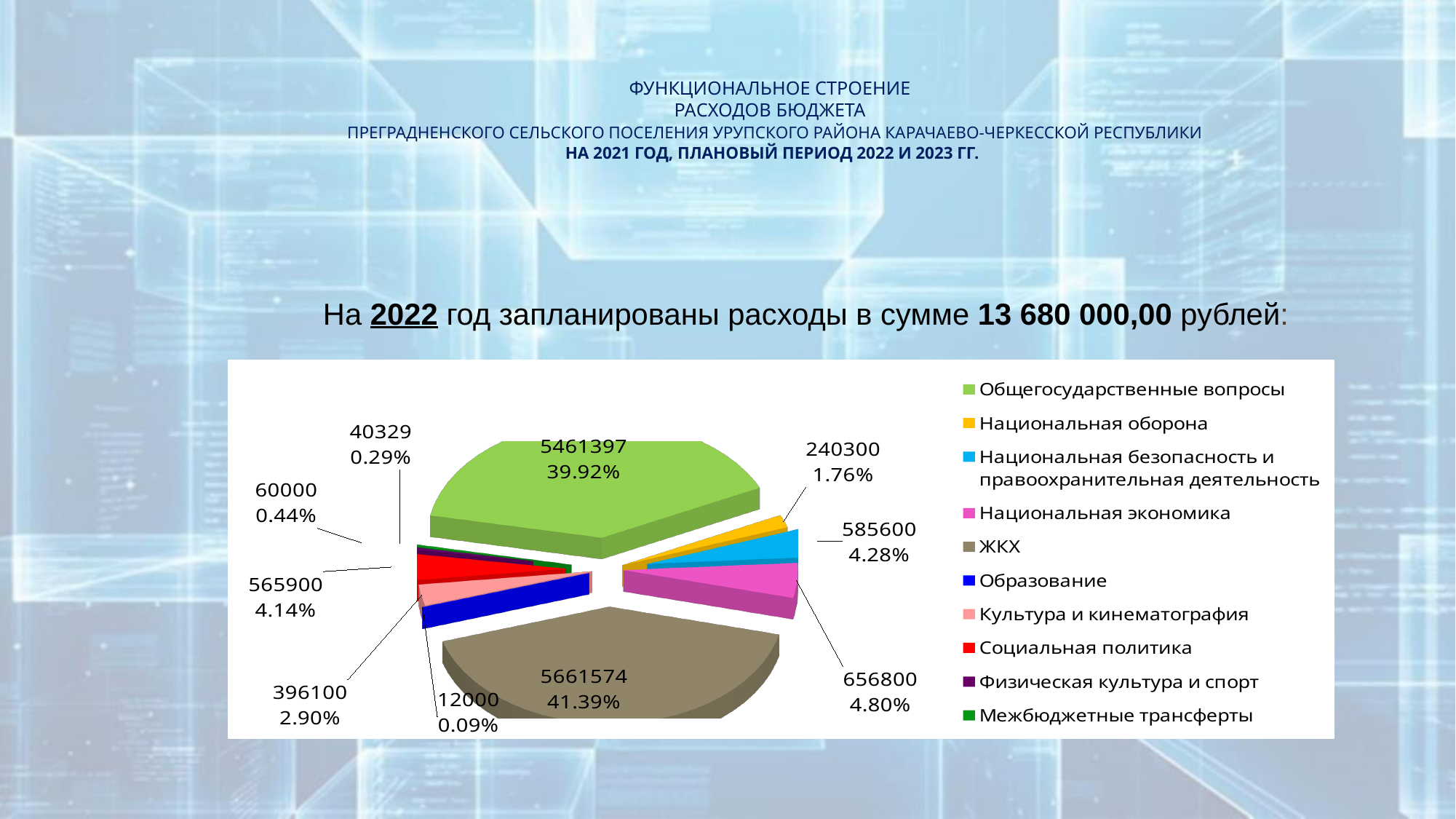
Which is larger, ЖКХ or Общегосударственные вопросы? ЖКХ What is the value shown for Общегосударственные вопросы? 5461397 Which category has the largest slice of the pie? ЖКХ What share of the pie does ЖКХ represent? 41.39% What share of the pie does Общегосударственные вопросы represent? 39.92% What kind of chart is shown on the slide? pie chart What is the value shown for ЖКХ? 5661574 What is the smallest value labelled on the pie chart? 12000 What is the value shown for Национальная экономика? 656800 What share of the pie does Национальная оборона represent? 1.76% What is the difference between the values for ЖКХ and Общегосударственные вопросы? 200177 How many categories does the legend of the pie chart list? 10